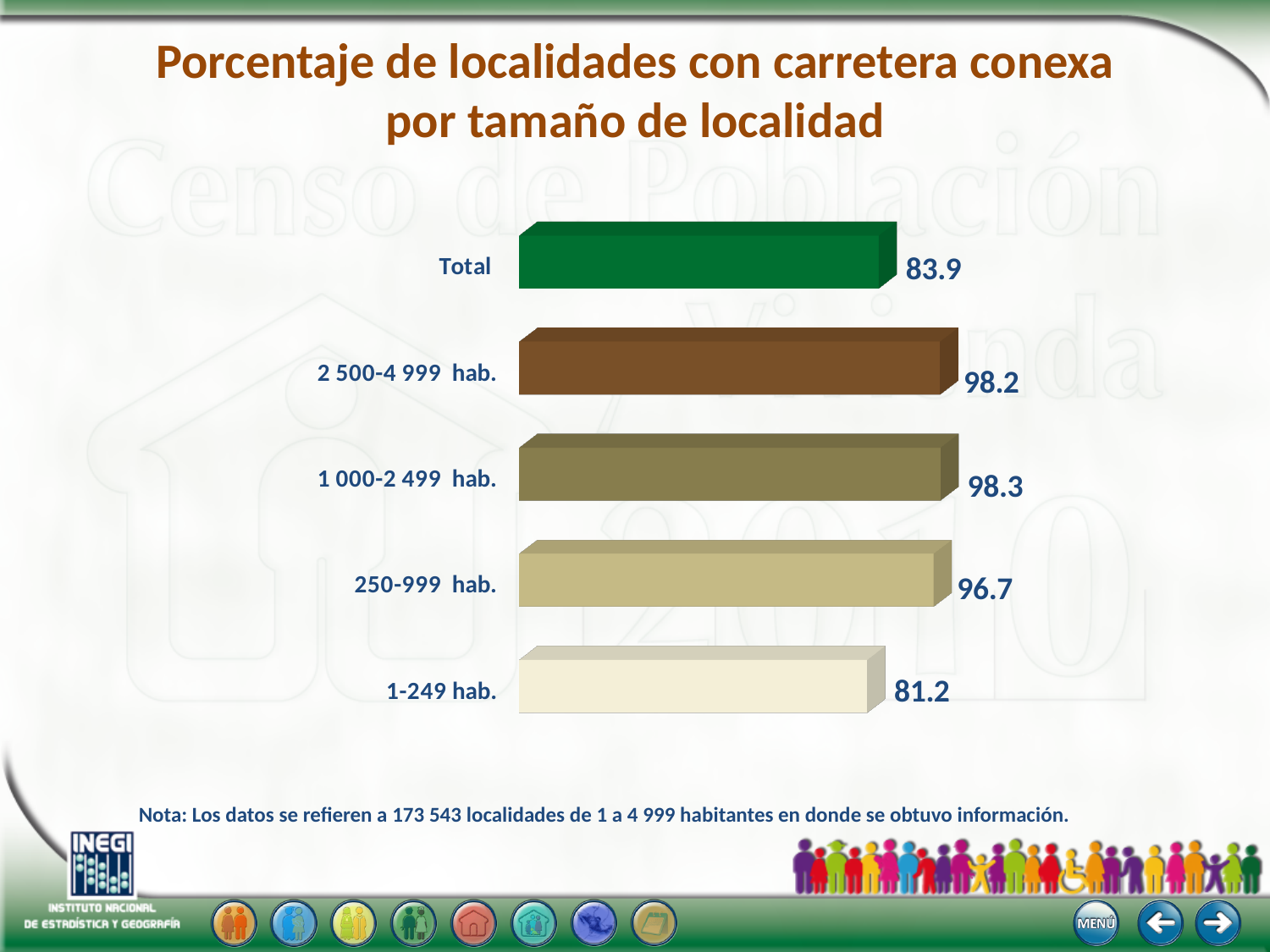
Which is larger, the value for 250-999 hab. or the value for 1-249 hab.? 250-999 hab. How many categories are shown in the chart? 5 What is the value for localities of 250-999 hab.? 96.7 What is the value for localities of 2 500-4 999 hab.? 98.2 What is the difference between the values for Total and 1-249 hab.? 2.7 What is the title of the chart? Porcentaje de localidades con carretera conexa por tamaño de localidad What is the difference between the values for 1 000-2 499 hab. and 250-999 hab.? 1.6 What is the value for localities of 1-249 hab.? 81.2 Which category has the lowest value? 1-249 hab. What kind of chart is shown on the slide? Bar chart What is the value for localities of 1 000-2 499 hab.? 98.3 What is the value for Total? 83.9